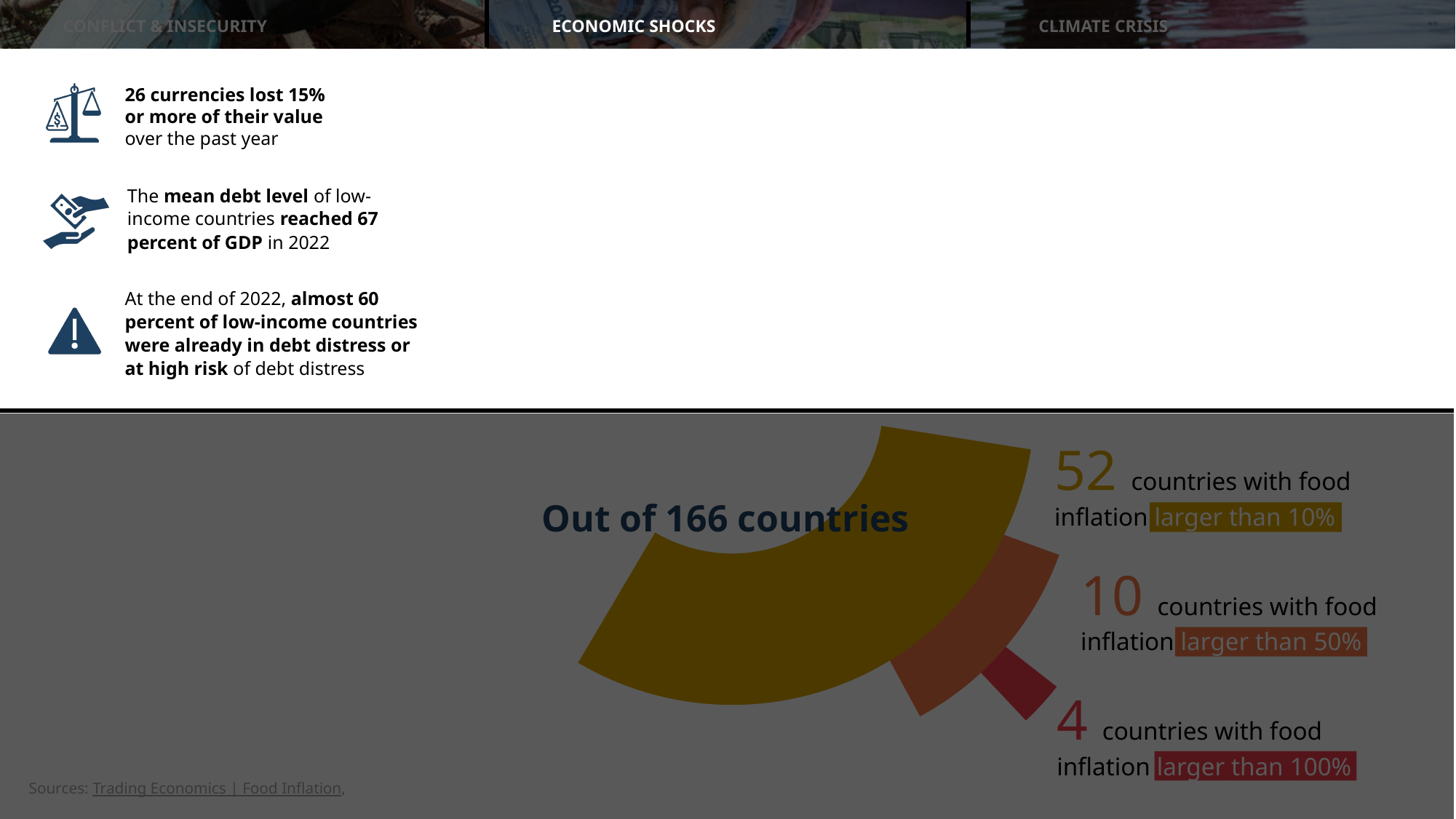
Which food inflation category has the smallest number of countries? larger than 100% Which is larger: the number of countries with food inflation larger than 50% or larger than 100%? larger than 50% Which food inflation category has the largest number of countries? larger than 10% How many countries have food inflation larger than 50%? 10 How many more countries have food inflation larger than 10% than larger than 50%? 42 How many countries have food inflation larger than 100%? 4 What is the difference between the number of countries with food inflation larger than 50% and larger than 100%? 6 What colour is the segment for countries with food inflation larger than 10%? Yellow Out of how many countries in total are the food inflation figures reported? 166 How many food inflation categories are shown in the chart? 3 How many countries have food inflation larger than 10%? 52 What colour is the segment for countries with food inflation larger than 100%? Red